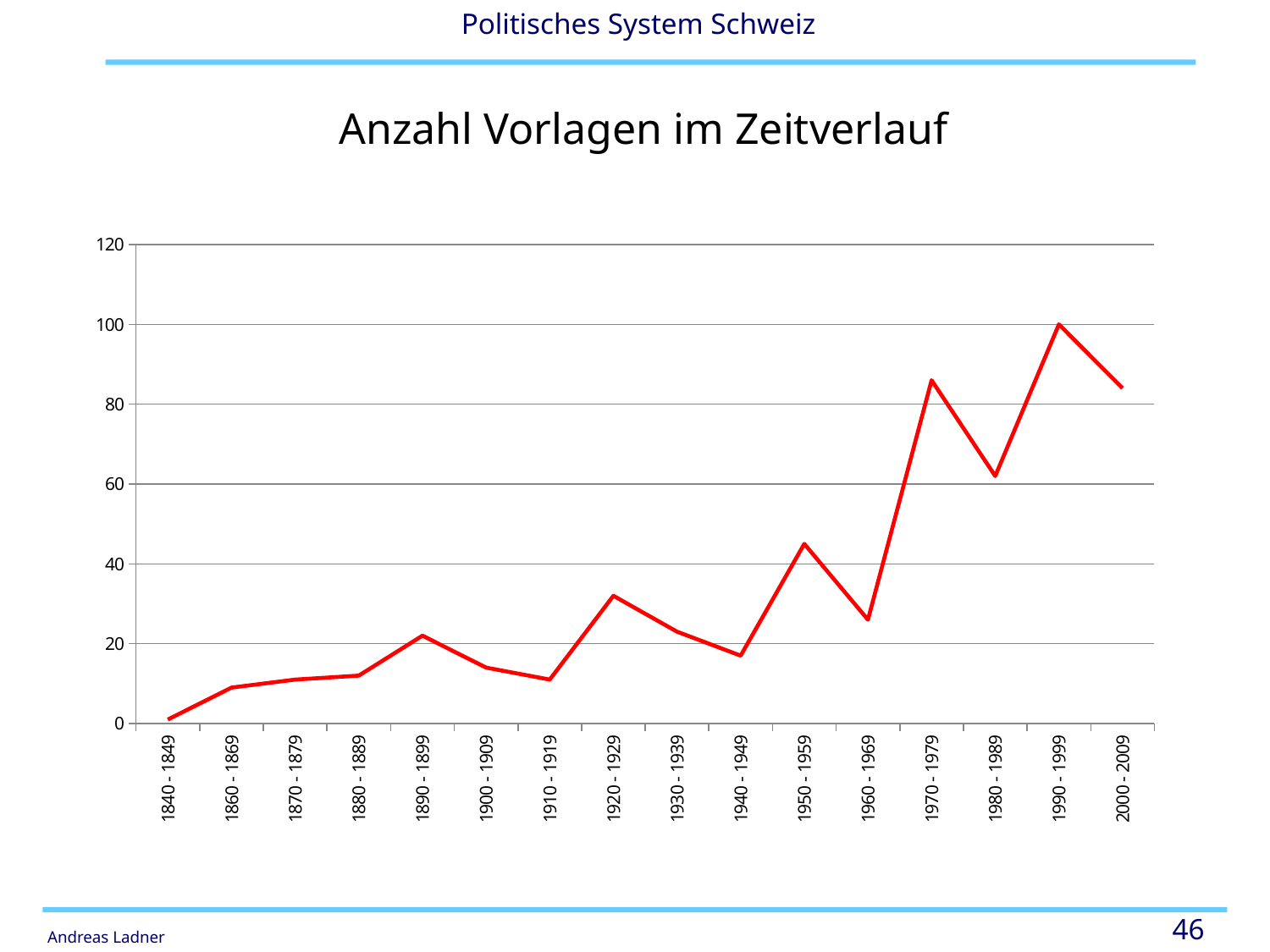
What is the title of the chart? Anzahl Vorlagen im Zeitverlauf Overall, do the values rise or fall from 1840 - 1849 to 2000 - 2009? rise Is the value for 1970 - 1979 greater or less than 80? greater What is the value for 1990 - 1999? 100 What kind of chart is shown on the slide? line chart Is the value for 1980 - 1989 greater or less than 80? less Which decade has the lowest value? 1840 - 1849 Which decade has the highest value? 1990 - 1999 How many decade categories are shown on the x axis? 16 Which is larger, the value for 1970 - 1979 or the value for 1980 - 1989? 1970 - 1979 Is the value for 1960 - 1969 greater or less than 40? less